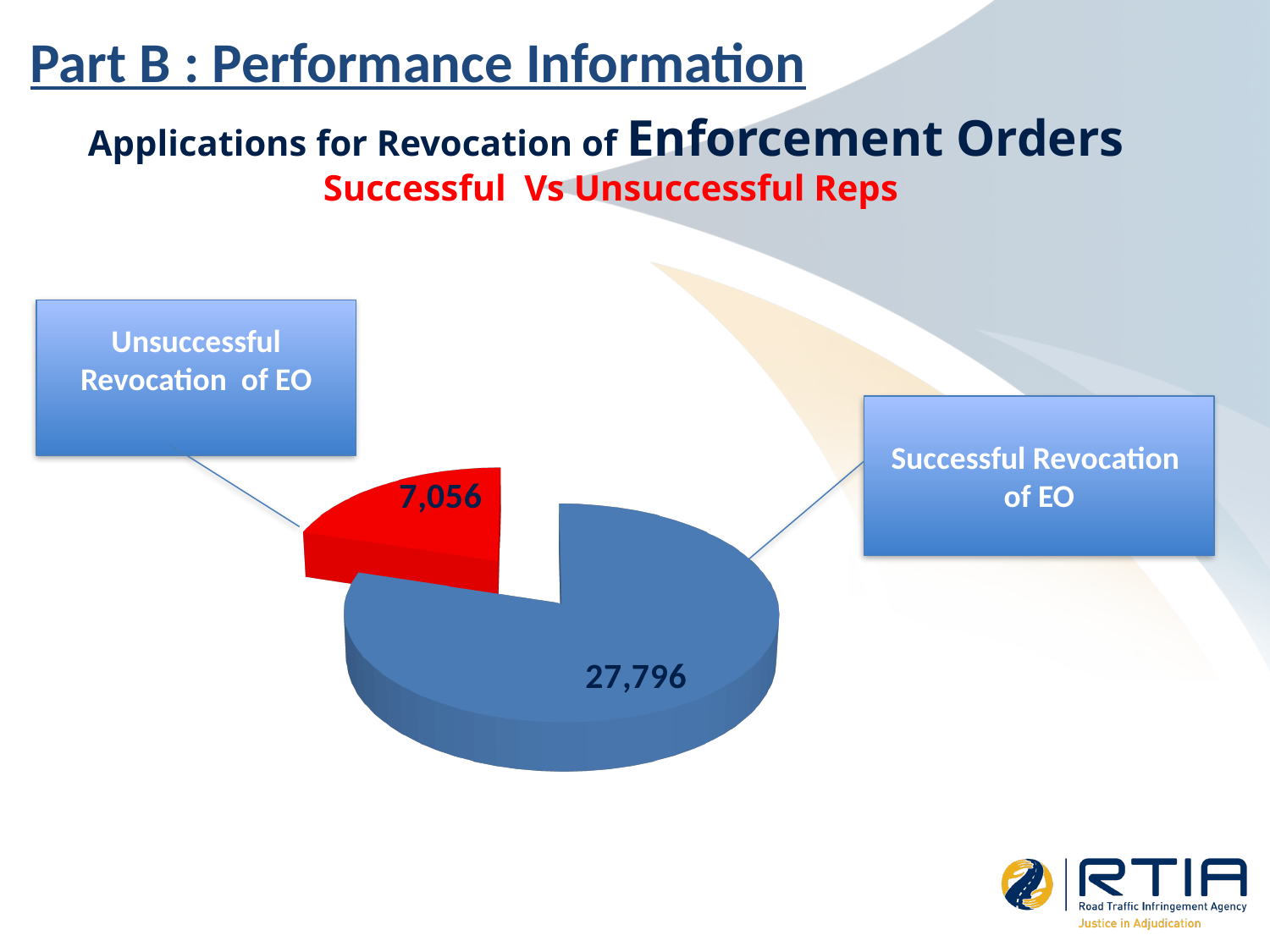
What share of the pie does Unsuccessful Revocation of EO represent, to the nearest whole percent? 20% How many slices does the pie chart have? 2 Which category has the largest slice of the pie? Successful Revocation of EO What is the difference between Successful Revocation of EO and Unsuccessful Revocation of EO? 20,740 Which is larger, Successful Revocation of EO or Unsuccessful Revocation of EO? Successful Revocation of EO What colour is the Unsuccessful Revocation of EO slice? Red What share of the pie does Successful Revocation of EO represent, to the nearest whole percent? 80% Which category has the smallest slice of the pie? Unsuccessful Revocation of EO What is the value for Unsuccessful Revocation of EO? 7,056 What is the value for Successful Revocation of EO? 27,796 What kind of chart is shown on the slide? Pie chart What is the total of the two slices in the pie chart? 34,852